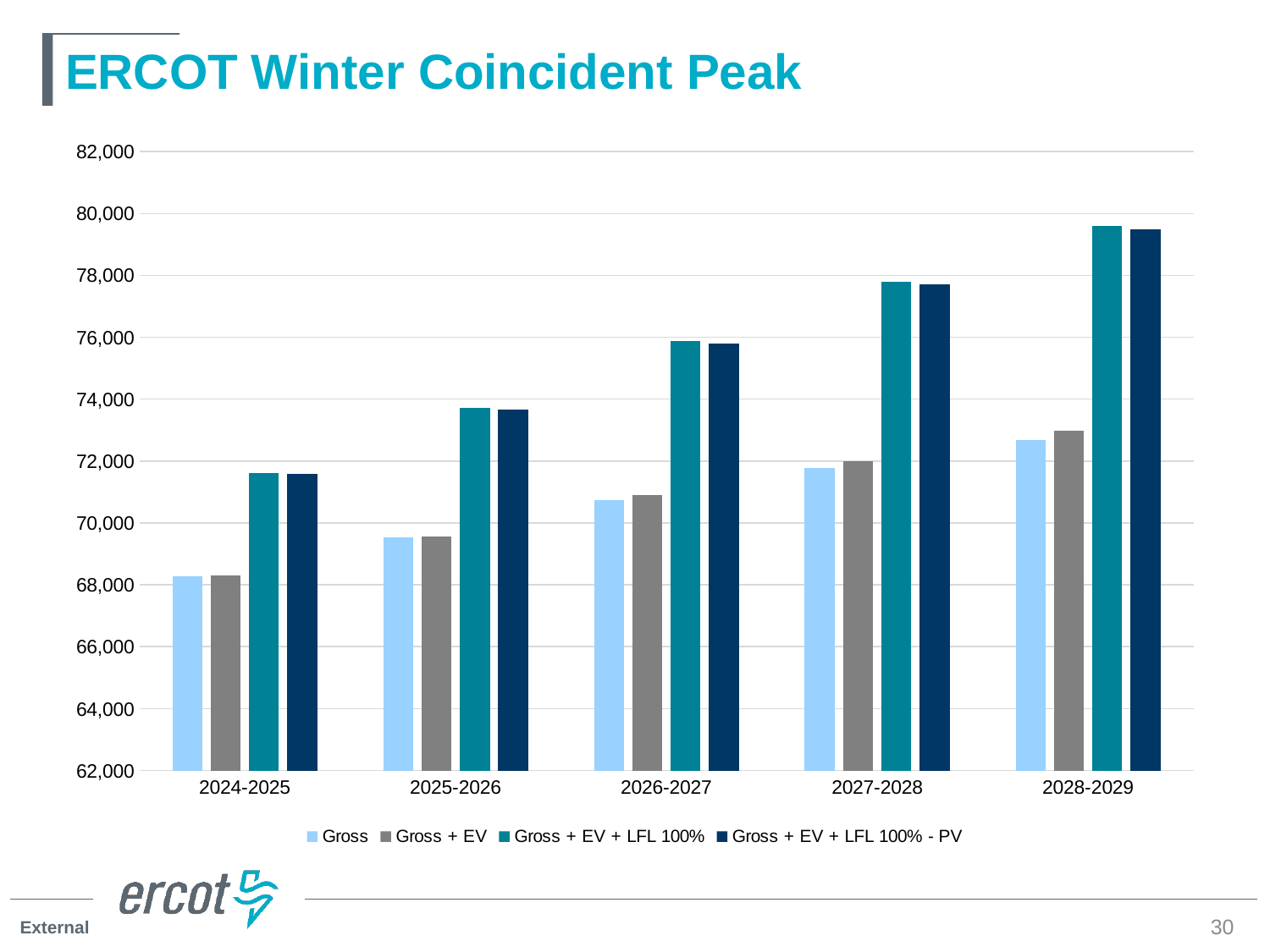
How many series does the legend list? 4 In 2026-2027, which is larger: Gross or Gross + EV + LFL 100%? Gross + EV + LFL 100% Do the Gross values rise or fall from 2024-2025 to 2028-2029? rise Which winter season has the highest Gross value? 2028-2029 Which winter season has the lowest Gross + EV + LFL 100% value? 2024-2025 What is the title of the chart? ERCOT Winter Coincident Peak Is the Gross + EV value for 2025-2026 greater or less than 70,000? less Is the Gross value for 2028-2029 greater or less than 72,000? greater Is the Gross value for 2024-2025 greater or less than 70,000? less How many winter seasons are shown on the x axis? 5 What kind of chart is shown on the slide? bar chart